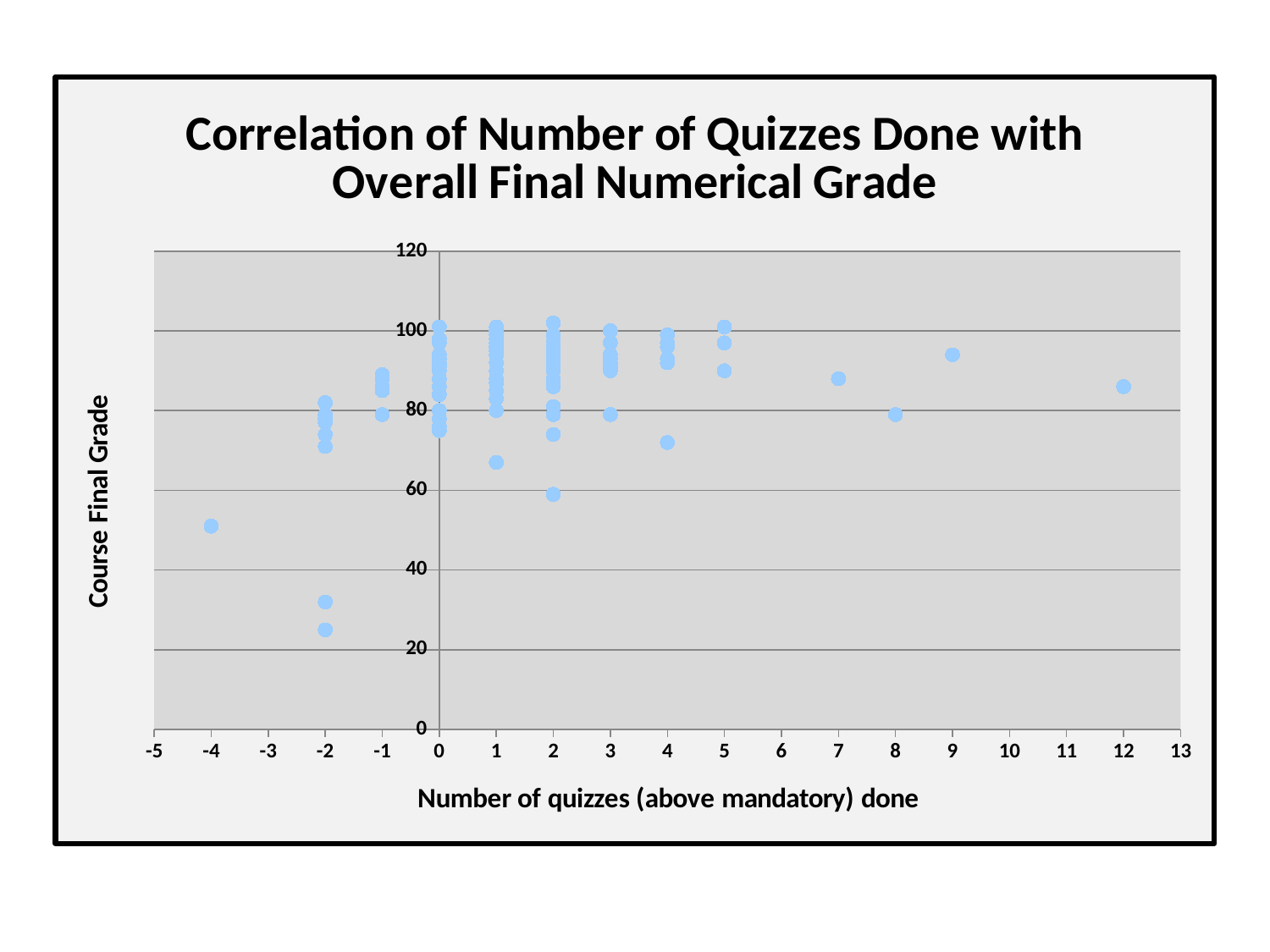
What is the label of the x axis? Number of quizzes (above mandatory) done Is the course final grade for the point at -4 quizzes greater or less than 60? less Is the course final grade for the point at -4 quizzes greater or less than 40? greater Is the lowest point at 2 quizzes greater or less than 80? less What kind of chart is shown on the slide? scatter chart What is the title of the chart? Correlation of Number of Quizzes Done with Overall Final Numerical Grade At which number of quizzes does the lowest course final grade on the chart occur? -2 Which is higher: the point at 9 quizzes or the point at 8 quizzes? 9 quizzes